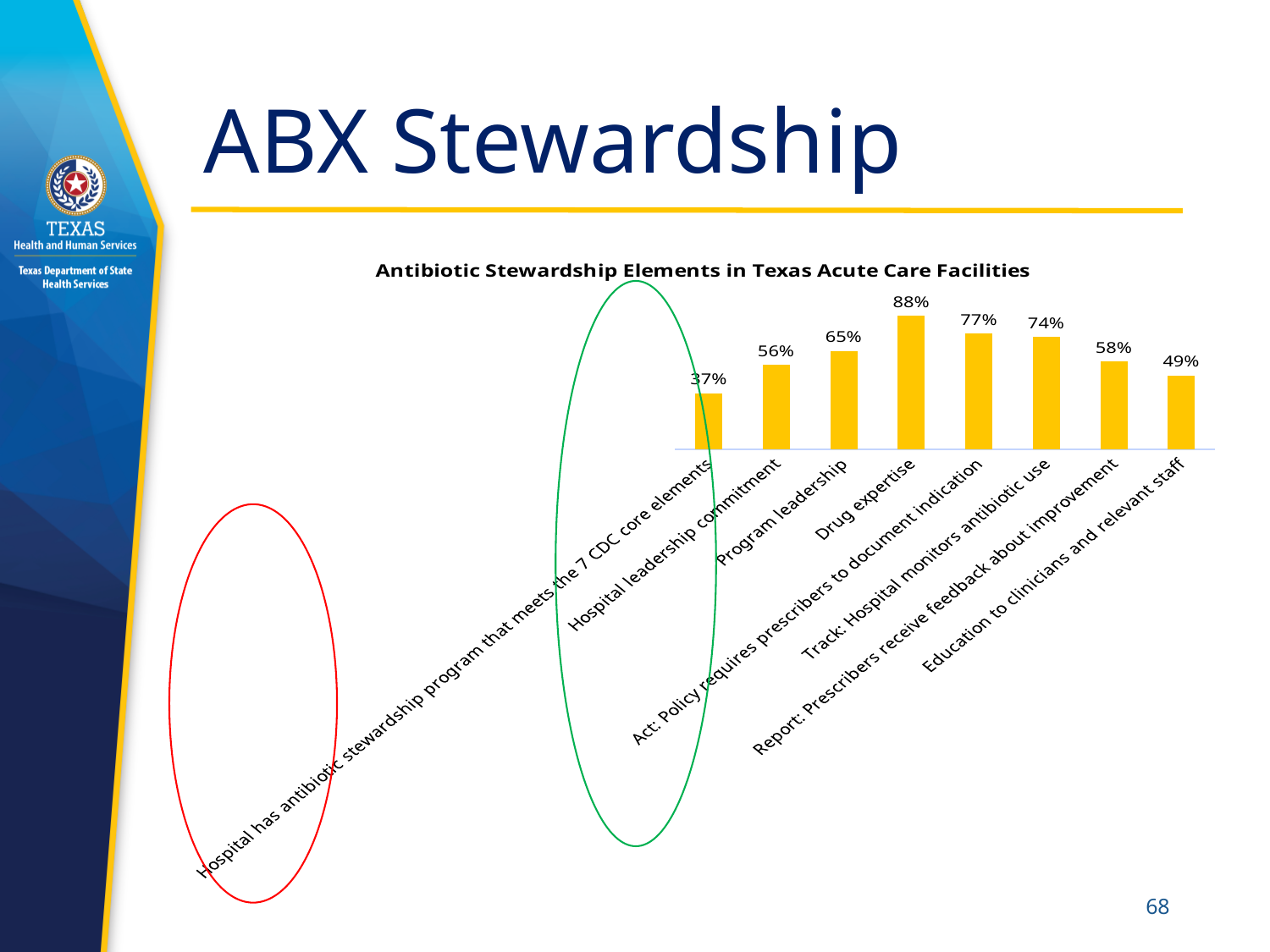
What is the difference between the values for Drug expertise and Program leadership? 23% What is the value for Track: Hospital monitors antibiotic use? 74% What kind of chart is shown on the slide? Bar chart What is the difference between the values for Hospital leadership commitment and Hospital has antibiotic stewardship program that meets the 7 CDC core elements? 19% Which category has the highest value? Drug expertise What is the title of the chart? Antibiotic Stewardship Elements in Texas Acute Care Facilities Which is larger, the value for Act: Policy requires prescribers to document indication or the value for Report: Prescribers receive feedback about improvement? Act: Policy requires prescribers to document indication What is the value for Education to clinicians and relevant staff? 49% How many categories are shown in the chart? 8 What is the value for Hospital leadership commitment? 56% What is the value for Drug expertise? 88% Which category has the lowest value? Hospital has antibiotic stewardship program that meets the 7 CDC core elements